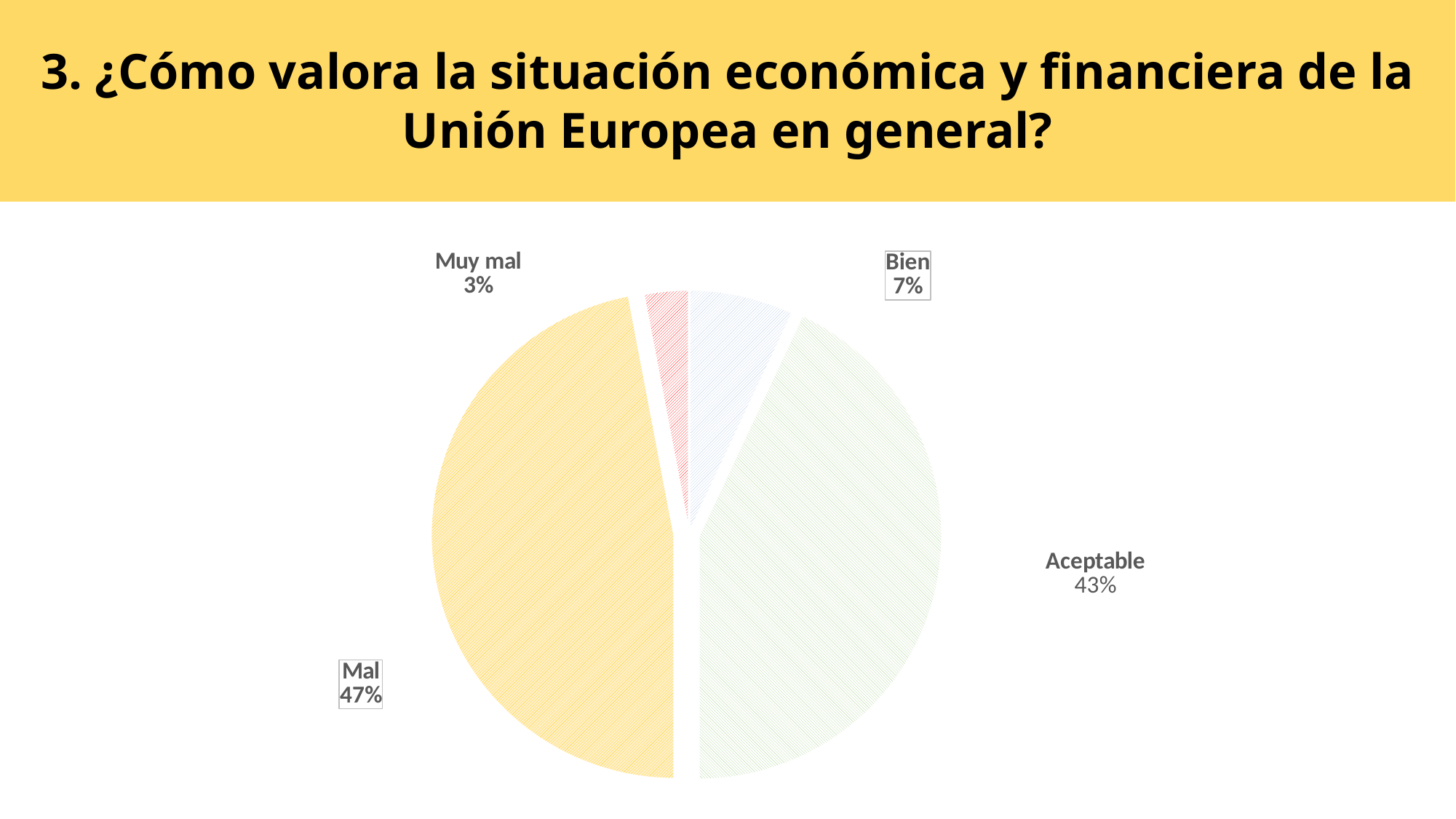
How many response categories are shown in the pie chart? 4 Which response category has the largest share of the pie? Mal What percentage of respondents answered "Mal"? 47% What kind of chart is shown on the slide? Pie chart What percentage of respondents answered "Aceptable"? 43% What is the difference in percentage points between "Mal" and "Aceptable"? 4 What is the combined share of "Mal" and "Muy mal"? 50% What percentage of respondents answered "Muy mal"? 3% What is the difference in percentage points between "Bien" and "Muy mal"? 4 Which response category has the smallest share of the pie? Muy mal Which is larger, the share for "Bien" or the share for "Muy mal"? Bien What percentage of respondents answered "Bien"? 7%